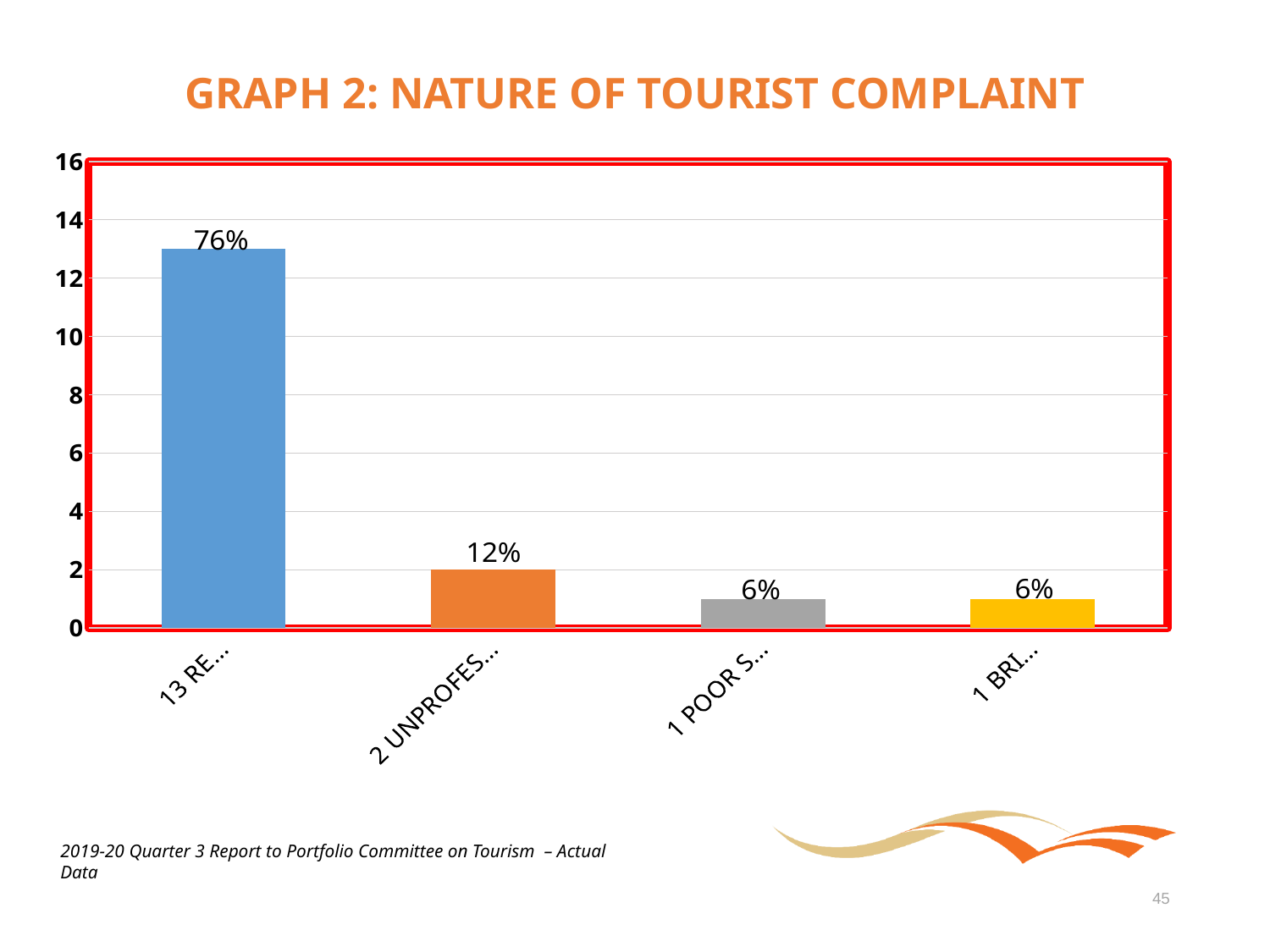
At which y-axis tick does the top of the orange bar land? 2 What is the title of the chart? GRAPH 2: NATURE OF TOURIST COMPLAINT Which bar has the highest value? the first (blue) bar, "13 RE..." What percentage label is shown on the orange bar, labelled "2 UNPROFES..."? 12% Is the value of the first (blue) bar greater or less than 14 on the y axis? less What type of chart is shown on the slide? bar chart What percentage label is shown on the grey bar, labelled "1 POOR S..."? 6% What is the difference between the percentage labels on the blue bar and the orange bar? 64% How many bars are plotted in the chart? 4 What percentage label is shown on the first (blue) bar, labelled "13 RE..."? 76% Which is larger: the orange bar or the grey bar? the orange bar Is the value of the first (blue) bar greater or less than 12 on the y axis? greater